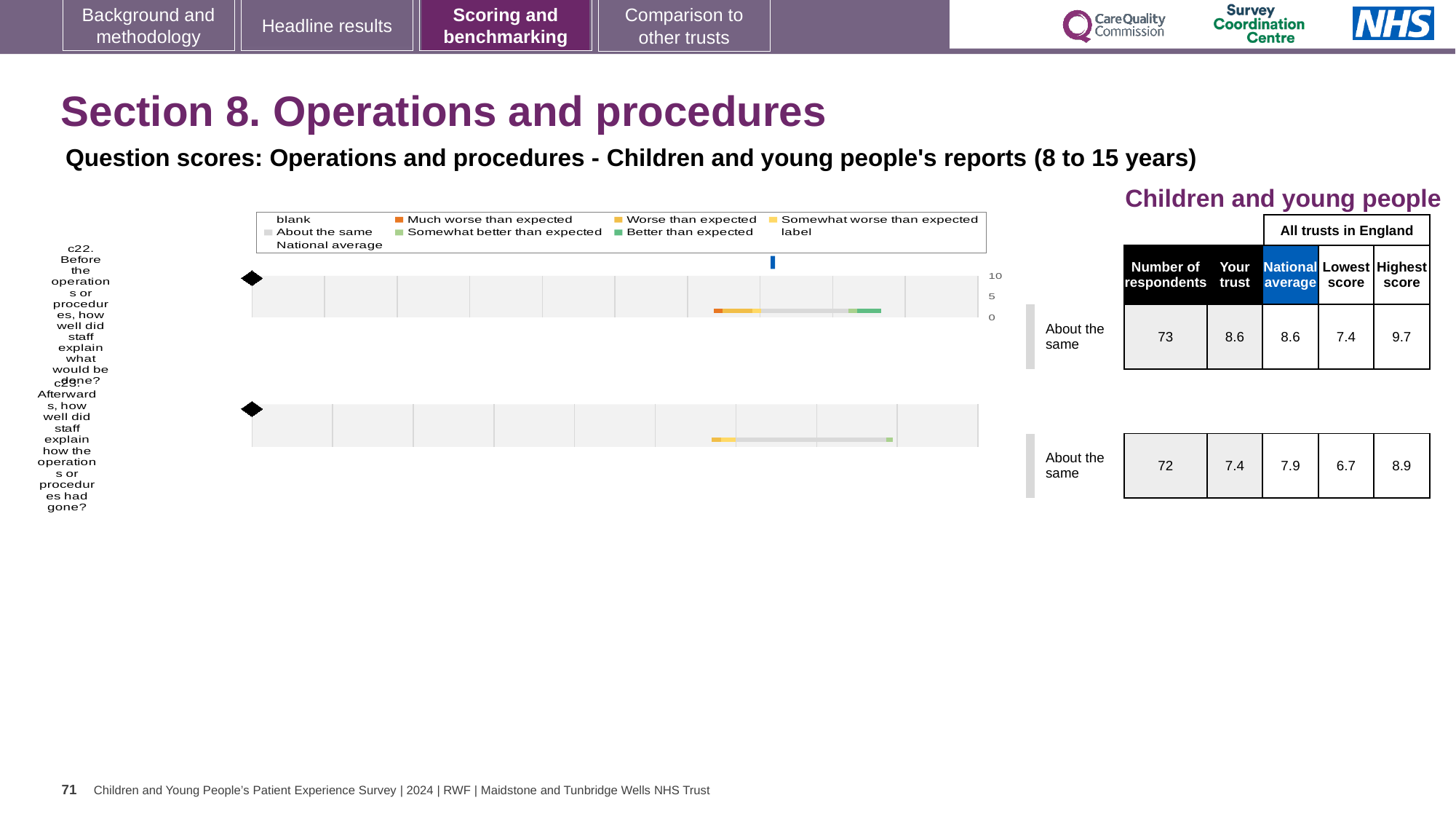
What is the difference between the highest score and the lowest score for question c22? 2.3 How many respondents answered question c22? 73 What kind of chart is used to show the question scores for c22 and c23? bar chart What benchmark category is shown next to both chart rows for the trust's results? About the same What colour in the legend represents 'Much worse than expected'? orange Which question has the higher 'Your trust' score, c22 or c23? c22 What is the national average score for question c23 (Afterwards, how well did staff explain how the operations or procedures had gone?)? 7.9 How many survey questions (chart rows) are shown on the slide? 2 Which question has the higher national average, c22 or c23? c22 What is the 'Your trust' score for question c22 (Before the operations or procedures, how well did staff explain what would be done?)? 8.6 For question c23, how much lower is the trust's score than the national average? 0.5 What is the highest score among all trusts in England for question c23? 8.9